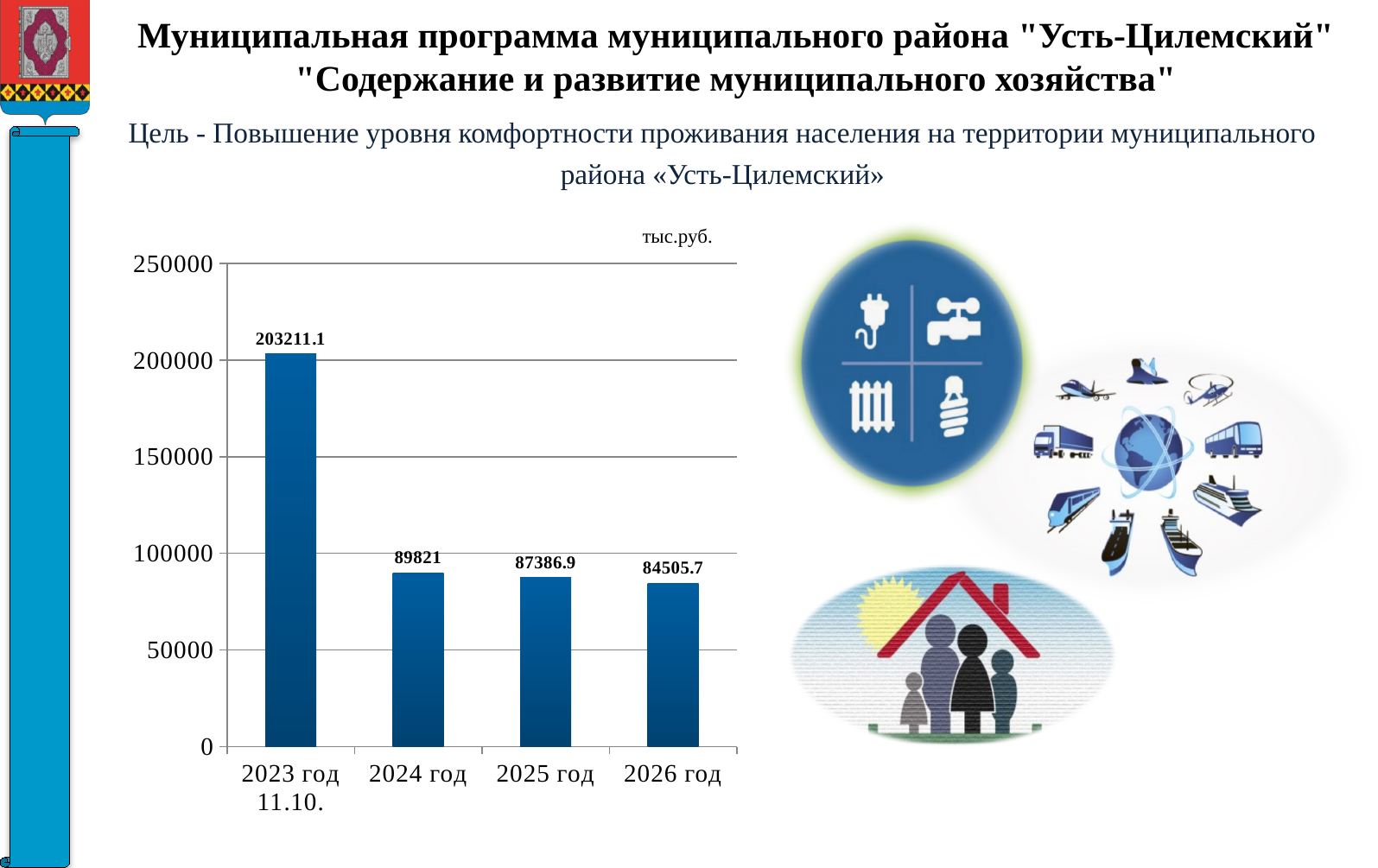
Is the value for 2023 год 11.10. greater or less than 200000? greater Which category has the lowest value? 2026 год What is the value for 2026 год? 84505.7 What kind of chart is shown on the slide? bar chart What is the value for 2025 год? 87386.9 What is the difference between the values for 2023 год 11.10. and 2024 год? 113390.1 What is the value for 2024 год? 89821 How many categories are shown on the x axis? 4 What is the value for 2023 год 11.10.? 203211.1 Which category has the highest value? 2023 год 11.10. Which is larger, the value for 2024 год or the value for 2025 год? 2024 год What is the difference between the values for 2025 год and 2026 год? 2881.2